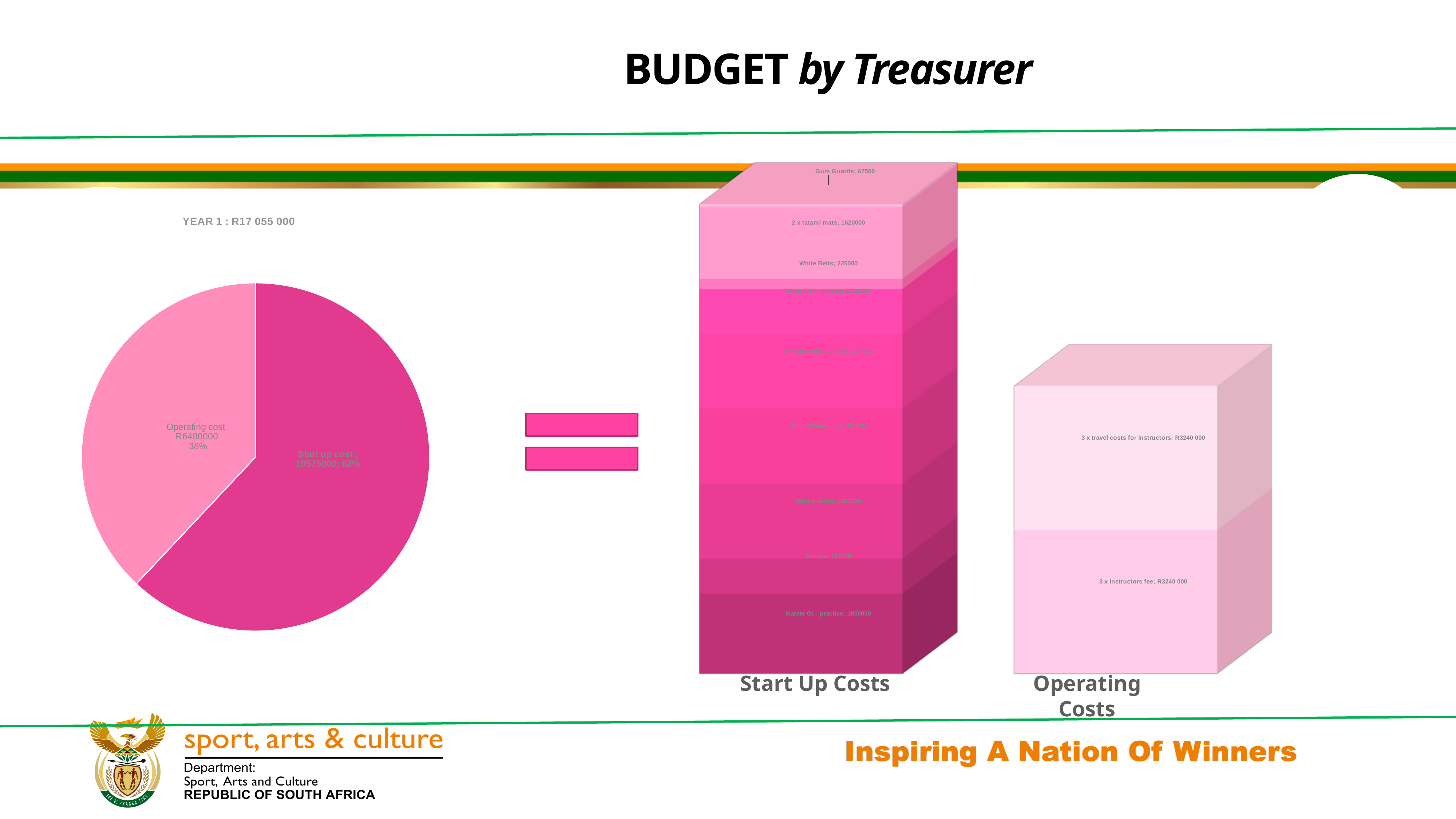
In the pie chart, what is the value shown for Start up cost? 10575000 In the pie chart, what share of the Year 1 budget is the Operating cost? 38% In the Start Up Costs stacked bar, what is the value for Karate Gi - practice? 1800000 In the Start Up Costs stacked bar, what is the value for 2 x tatami mats? 1620000 What is the title of the pie chart on the left? YEAR 1 : R17 055 000 In the pie chart, what is the value shown for Operating cost? R6480000 In the Operating Costs stacked bar, what is the value for 3 x Instructors fee? R3240 000 In the Start Up Costs stacked bar, what is the difference between 2 x tatami mats and White Belts? 1395000 In the pie chart, what share of the Year 1 budget is the Start up cost? 62% In the Start Up Costs stacked bar, what is the value for Gum Guards? 67500 How many slices does the pie chart have? 2 In the pie chart, which slice is larger, Operating cost or Start up cost? Start up cost